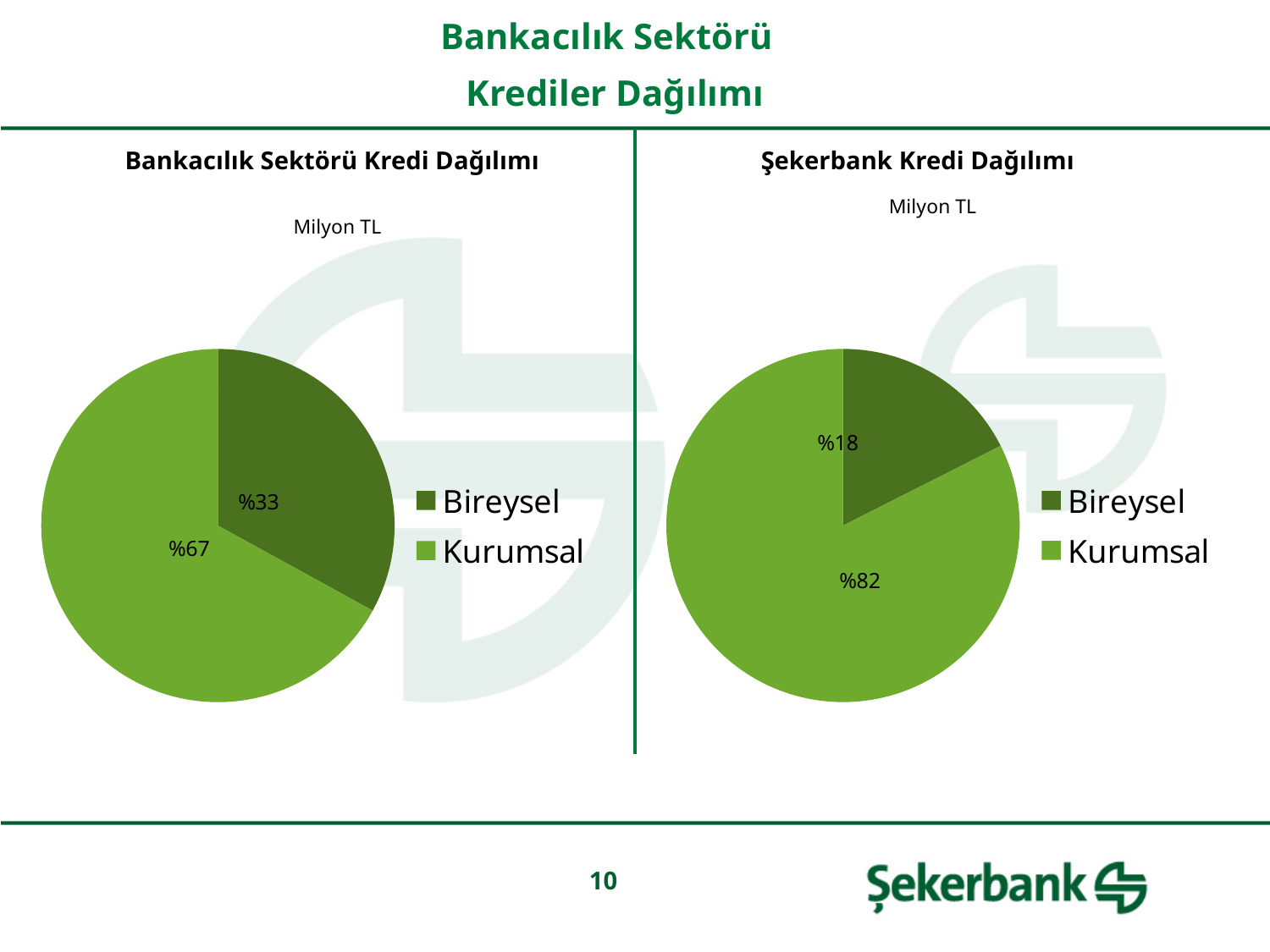
Which chart has the larger Bireysel share, 'Bankacılık Sektörü Kredi Dağılımı' or 'Şekerbank Kredi Dağılımı'? Bankacılık Sektörü Kredi Dağılımı In the 'Bankacılık Sektörü Kredi Dağılımı' chart, what share does Kurumsal have? %67 In the 'Şekerbank Kredi Dağılımı' chart, which slice is the largest? Kurumsal In the 'Şekerbank Kredi Dağılımı' chart, what share does Kurumsal have? %82 What entries does the legend of the 'Şekerbank Kredi Dağılımı' chart list? Bireysel, Kurumsal How many slices does the 'Bankacılık Sektörü Kredi Dağılımı' pie chart have? 2 In the 'Bankacılık Sektörü Kredi Dağılımı' chart, which slice is the smallest? Bireysel In the 'Şekerbank Kredi Dağılımı' chart, what share does Bireysel have? %18 What type of chart is the 'Şekerbank Kredi Dağılımı' chart? Pie chart In the 'Bankacılık Sektörü Kredi Dağılımı' chart, what is the difference between the Kurumsal and Bireysel shares? 34 percentage points In the 'Şekerbank Kredi Dağılımı' chart, what is the difference between the Kurumsal and Bireysel shares? 64 percentage points